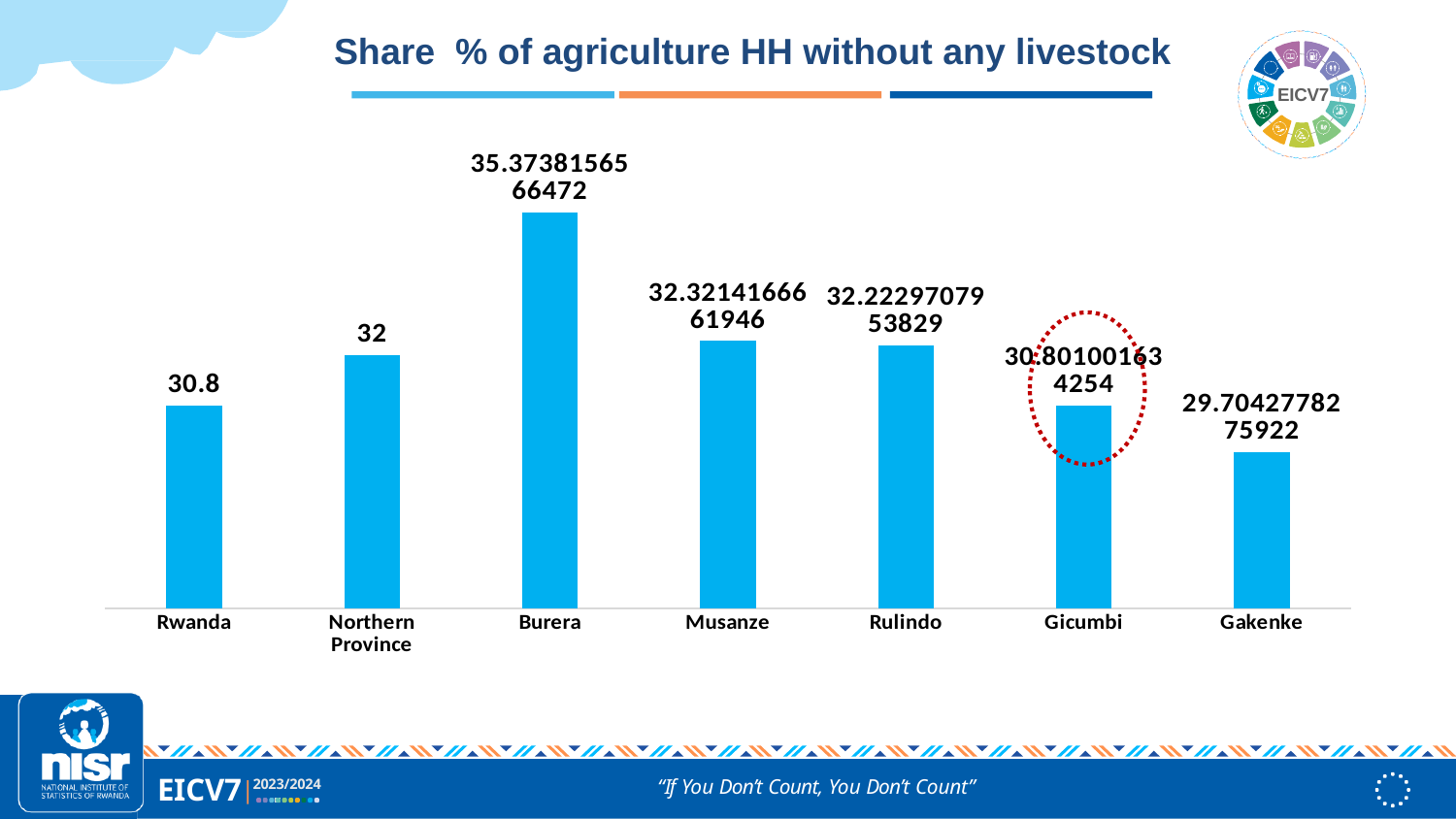
How many categories are shown on the x axis? 7 Which category's bar is highlighted with a red dotted circle? Gicumbi Which is larger, the value for Rwanda or the value for Northern Province? Northern Province What is the value for Gicumbi? 30.801001634254 What is the value for Rwanda? 30.8 What kind of chart is shown on the slide? Bar chart Which category has the lowest value? Gakenke What is the value for Gakenke? 29.7042778275922 What is the difference between the values for Northern Province and Rwanda? 1.2 What is the value for Northern Province? 32 Which category has the highest value? Burera What is the value for Burera? 35.3738156566472